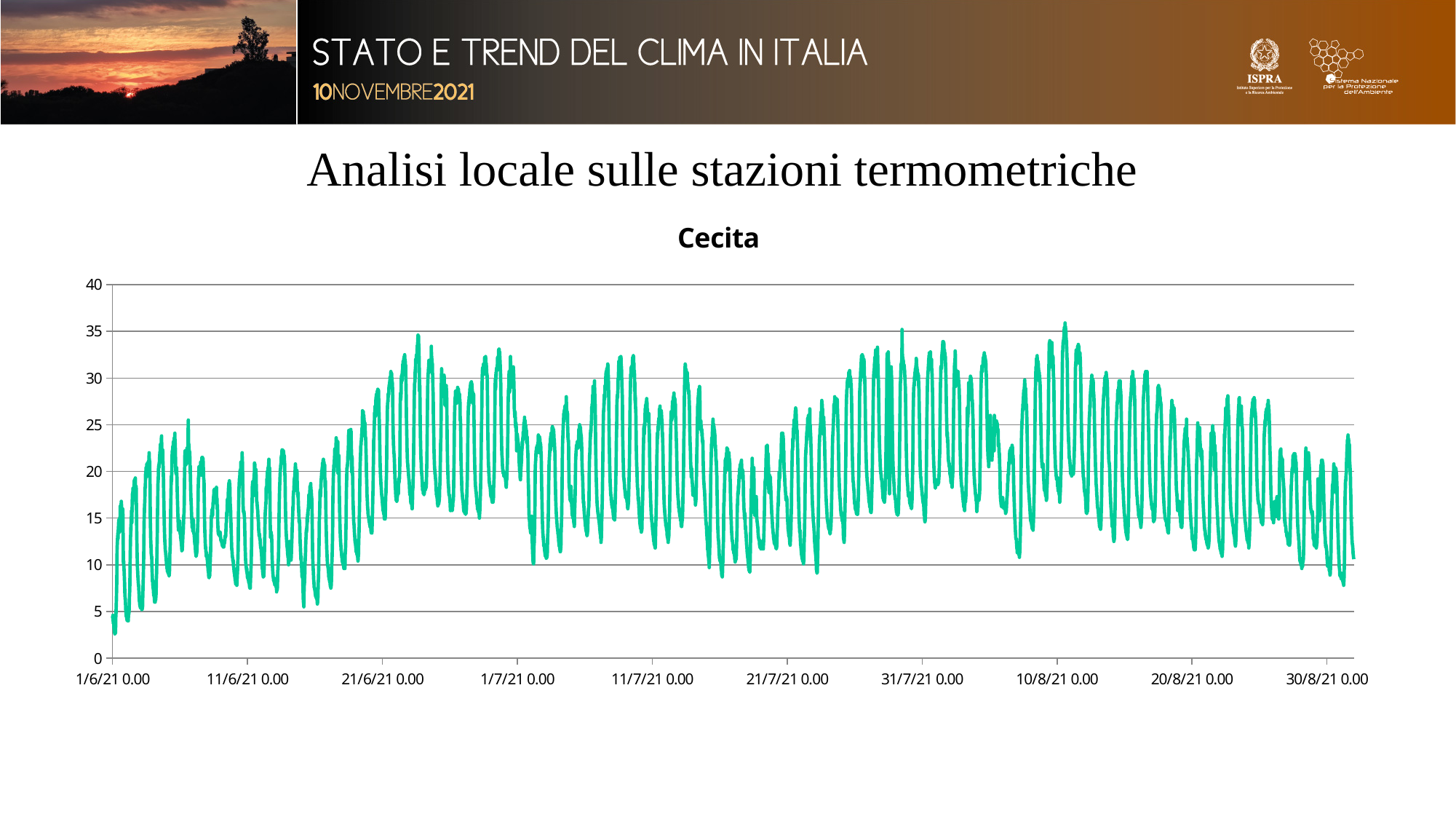
Is the highest peak of the line greater or less than 30? greater Is the value at the very end of the series, around 30/8/21, greater or less than 25? less What is the last date label on the horizontal axis? 30/8/21 0.00 Is the peak near 10/8/21 greater or less than 25? greater How many data series are plotted in the chart? 1 What is the highest value shown on the vertical axis of the chart? 40 What kind of chart is shown on the slide? Line chart How many date labels are shown on the horizontal axis? 10 What is the first date label on the horizontal axis? 1/6/21 0.00 What is the title of the chart? Cecita